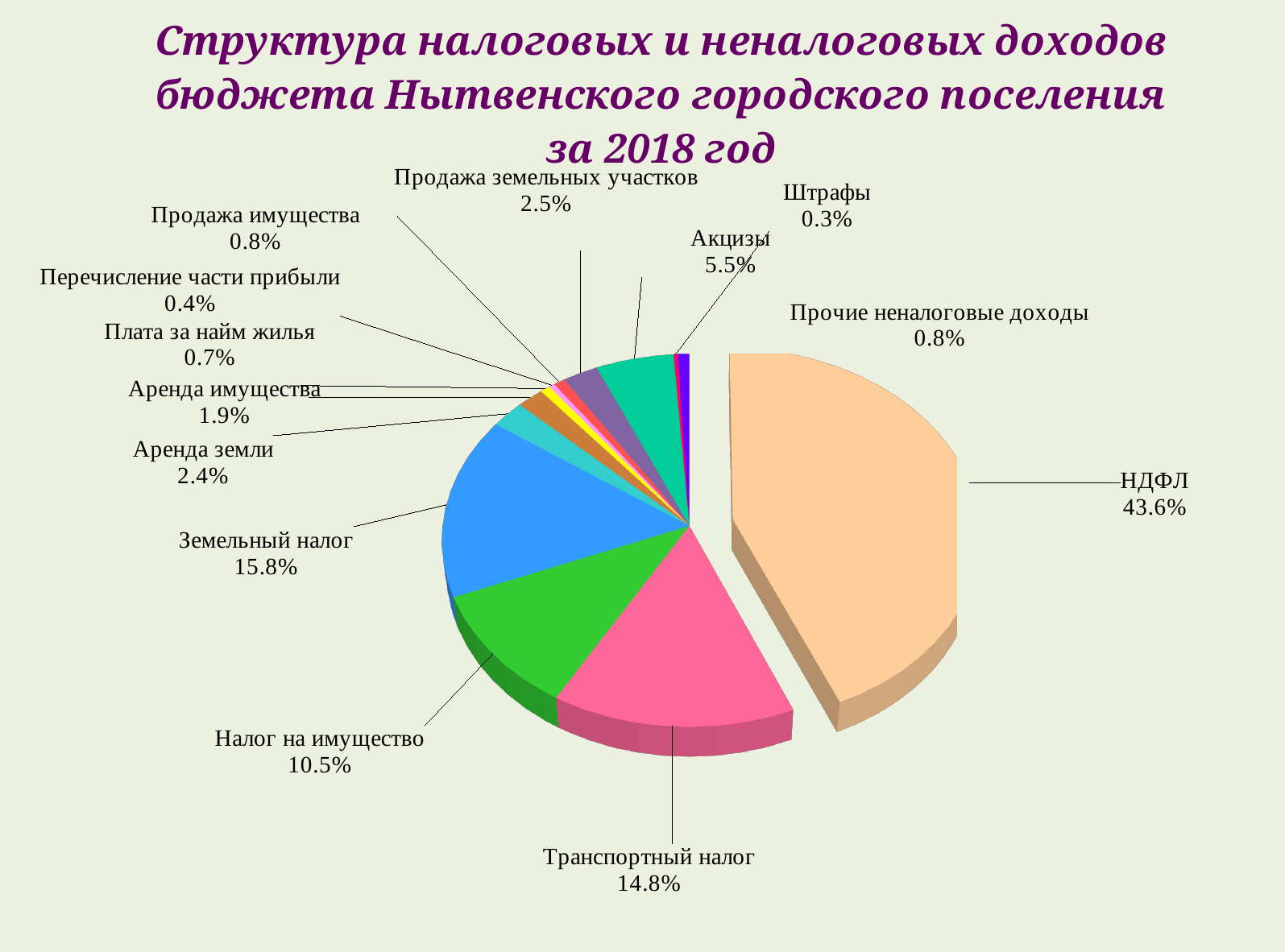
What is the value shown for Транспортный налог? 14.8% What share of the budget revenue does НДФЛ account for? 43.6% How many categories are shown in the pie chart? 13 What is the value shown for Акцизы? 5.5% What kind of chart is shown on the slide? pie chart What is the difference between the shares of Земельный налог and Транспортный налог? 1.0% What is the value shown for Земельный налог? 15.8% Which category has the largest share of the pie? НДФЛ Which category has the smallest share of the pie? Штрафы What year does the chart title say the data is for? 2018 What is the value shown for Аренда земли? 2.4% Which is larger, the share of Налог на имущество or the share of Акцизы? Налог на имущество